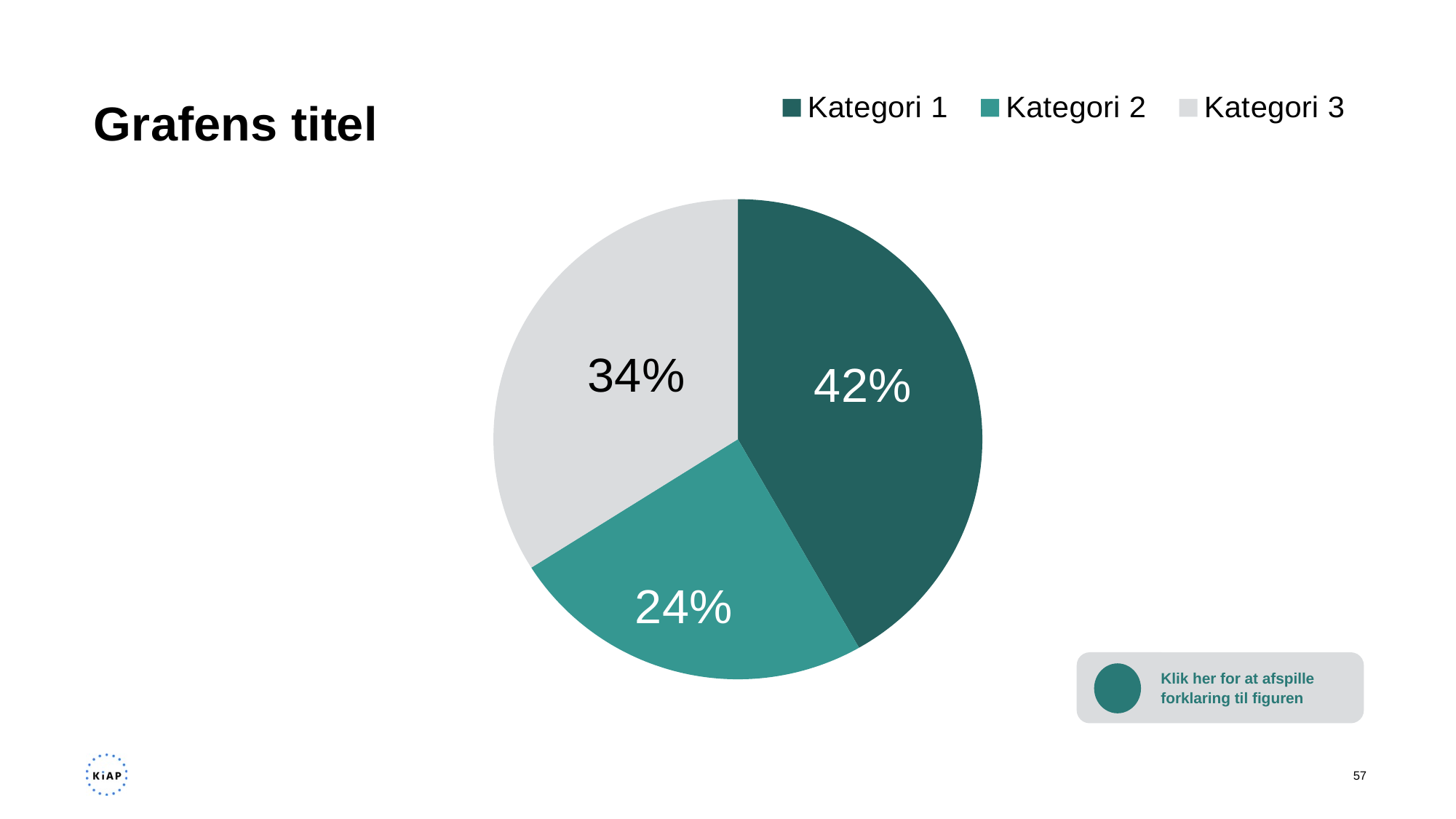
What is the title of the chart? Grafens titel What is the value for Kategori 2? 24% How many slices does the pie chart have? 3 Which category has the largest slice? Kategori 1 What kind of chart is shown on the slide? pie chart What is the value for Kategori 1? 42% Which category is shown in the light grey colour? Kategori 3 Which category has the smallest slice? Kategori 2 What is the difference between the values for Kategori 1 and Kategori 2? 18% Which is larger, the slice for Kategori 3 or the slice for Kategori 2? Kategori 3 What is the difference between the values for Kategori 3 and Kategori 2? 10% What is the value for Kategori 3? 34%